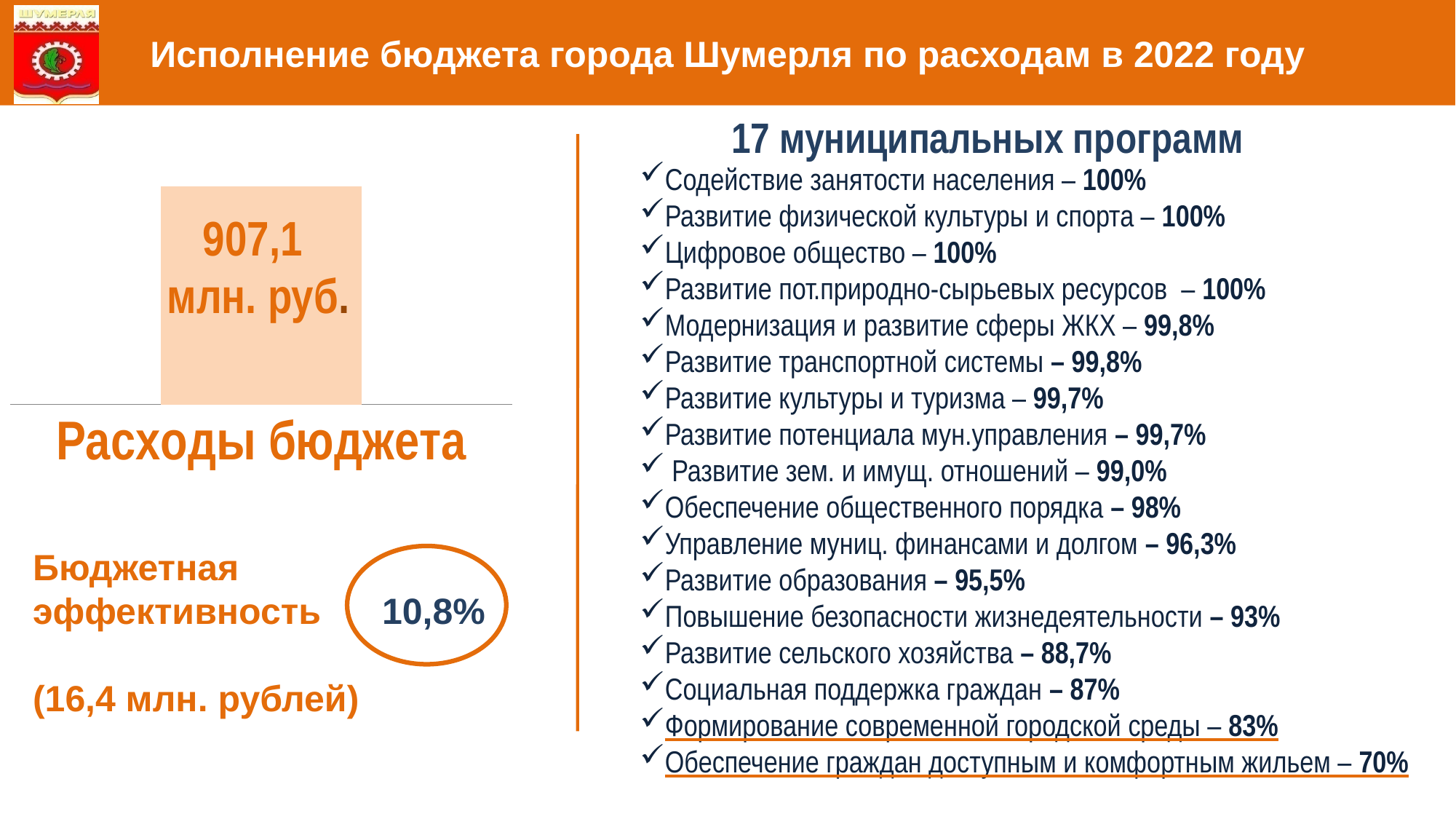
What is the category label under the bar in the chart on the left of the slide? Расходы бюджета How many bars does the chart on the left of the slide contain? 1 What value is shown on the bar in the chart on the left of the slide? 907,1 млн. руб. What kind of chart is shown on the left of the slide? bar chart What is the value of the bar labelled "Расходы бюджета"? 907,1 млн. руб. What colour is the bar in the chart on the left of the slide? light orange